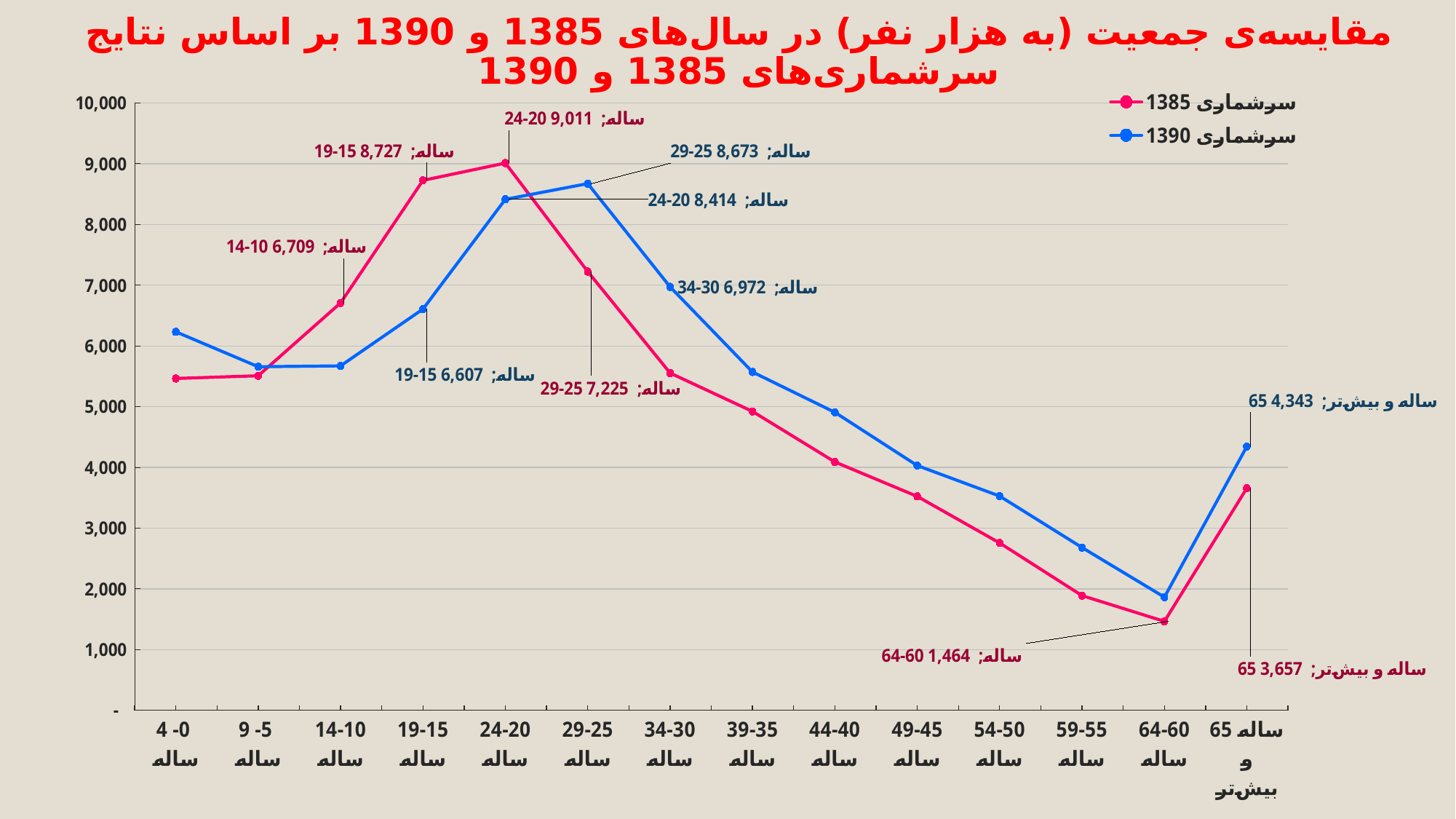
For the 19-15 age group, which series has the larger value, 1385 or 1390? 1385 Which age group has the highest value in the 1390 census series? 29-25 What is the difference between the 1390 and 1385 values for the 65 and over age group? 686 What is the value for the 24-20 age group in the 1385 census series? 9,011 Is the 1390 value for the 4-0 age group greater or less than 6,000? greater What is the value for the 64-60 age group in the 1385 census series? 1,464 What kind of chart is shown on the slide? line chart What is the difference between the 1385 and 1390 values for the 24-20 age group? 597 What is the value for the 65 and over age group in the 1390 census series? 4,343 What is the value for the 29-25 age group in the 1390 census series? 8,673 Which age group has the highest value in the 1385 census series? 24-20 How many age groups are shown on the x axis? 14